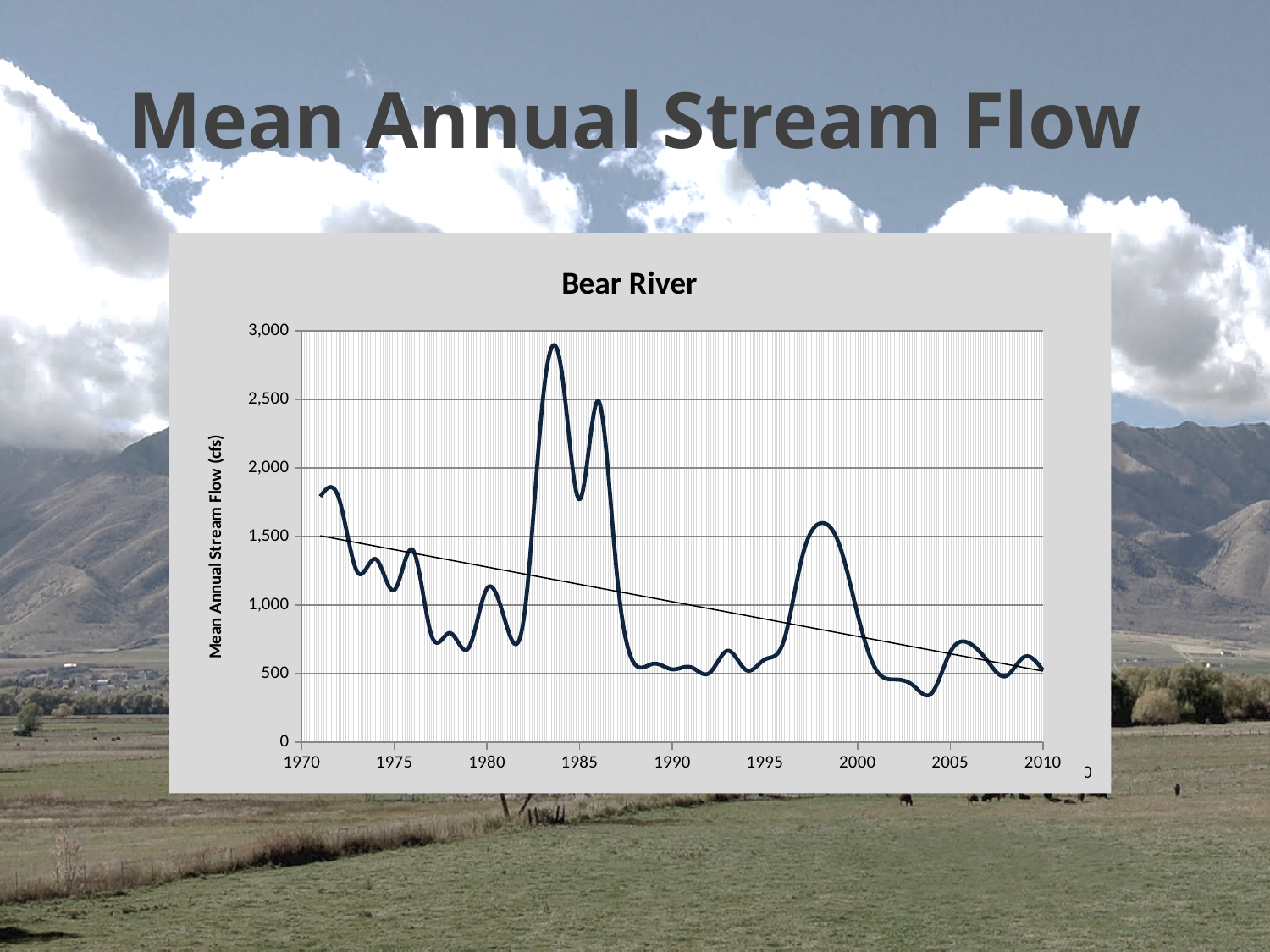
Which is larger, the stream flow in 1971 or in 2009? 1971 What is the highest value shown on the vertical axis? 3,000 Is the stream flow value for 1998 greater or less than 1,000? greater Is the stream flow value for 2004 greater or less than 500? less Does the straight trend line on the chart rise or fall from 1970 to 2010? fall Which is larger, the peak stream flow around 1984 or the peak around 1998? the peak around 1984 Is the stream flow value for 1971 greater or less than 1,500? greater What kind of chart is shown on the slide? line chart What is the title of the chart? Bear River What is the label on the vertical axis of the chart? Mean Annual Stream Flow (cfs)